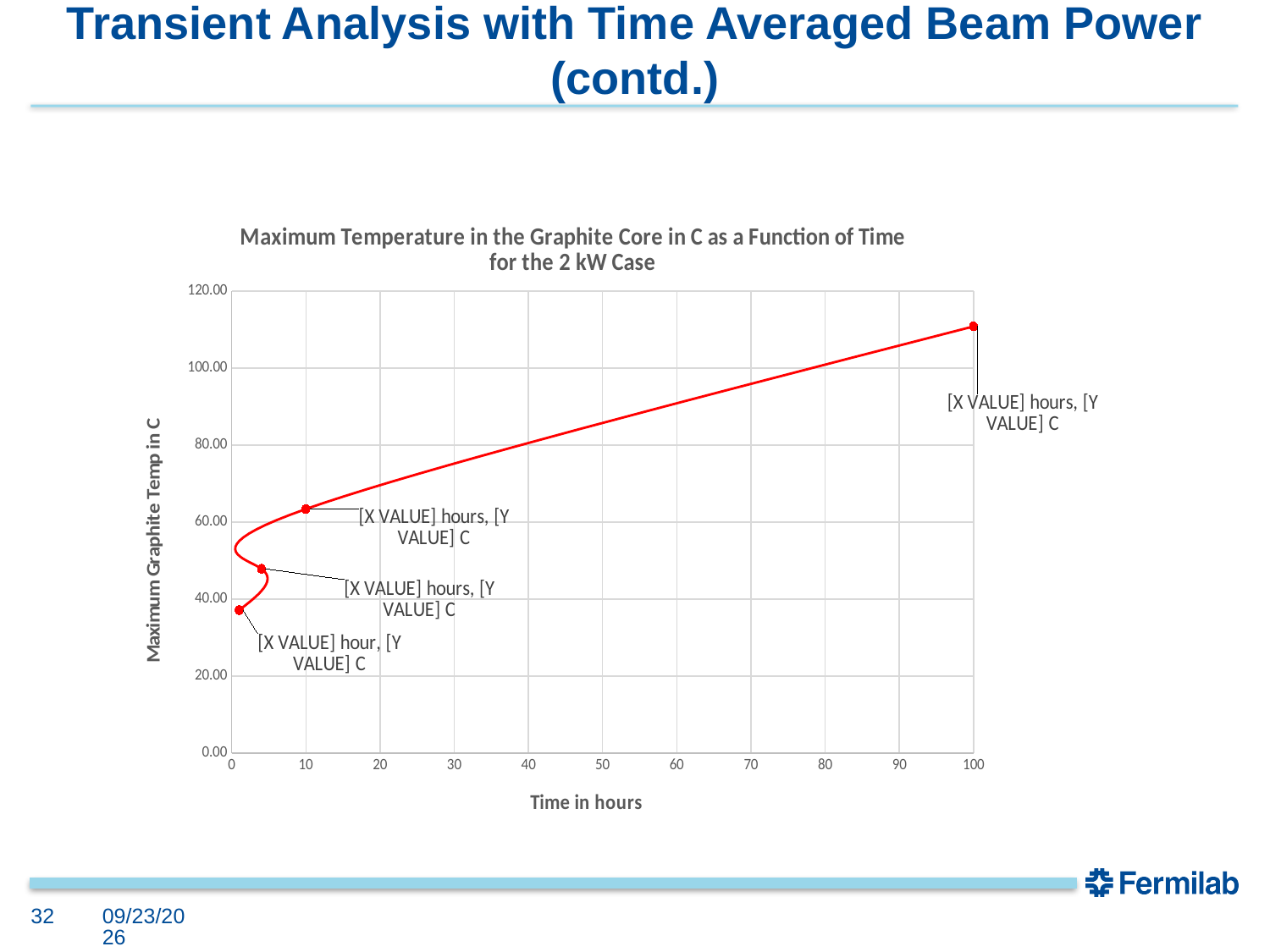
Which is larger, the maximum graphite temperature at 10 hours or at 100 hours? 100 hours At which marked time is the maximum graphite temperature highest? 100 hours Is the maximum graphite temperature at 100 hours greater or less than 100? greater Is the maximum graphite temperature at the first marked point (about 1 hour) greater or less than 60? less How many data points are marked on the curve? 4 What kind of chart is shown on the slide? line chart Is the maximum graphite temperature at 10 hours greater or less than 80? less Between 10 hours and 100 hours, does the maximum graphite temperature rise or fall? rise What is the title of the chart? Maximum Temperature in the Graphite Core in C as a Function of Time for the 2 kW Case What is the label of the x axis? Time in hours